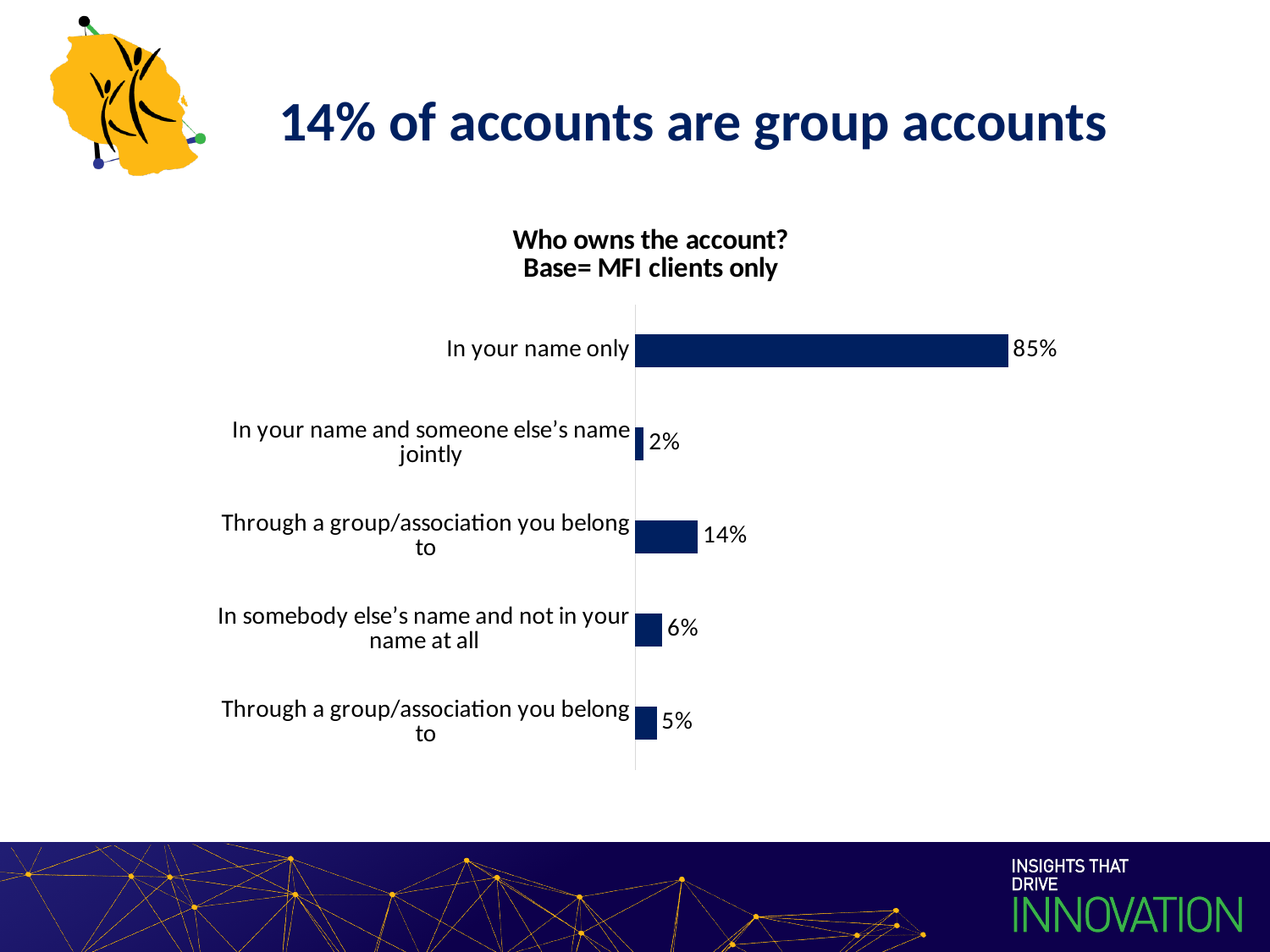
What is the value shown on the bottom bar of the chart? 5% Which is larger: 'In somebody else's name and not in your name at all' or 'In your name and someone else's name jointly'? In somebody else's name and not in your name at all What is the title of the chart? Who owns the account? Base= MFI clients only How many bars are shown in the chart? 5 Which category has the lowest value? In your name and someone else's name jointly What is the value shown on the third bar from the top, 'Through a group/association you belong to'? 14% What percentage of MFI clients have the account in their name only? 85% Which category has the highest value? In your name only What is the value for 'In somebody else's name and not in your name at all'? 6% What is the value for 'In your name and someone else's name jointly'? 2% What kind of chart is shown on the slide? Bar chart What is the difference between 'In your name only' and 'In somebody else's name and not in your name at all'? 79%